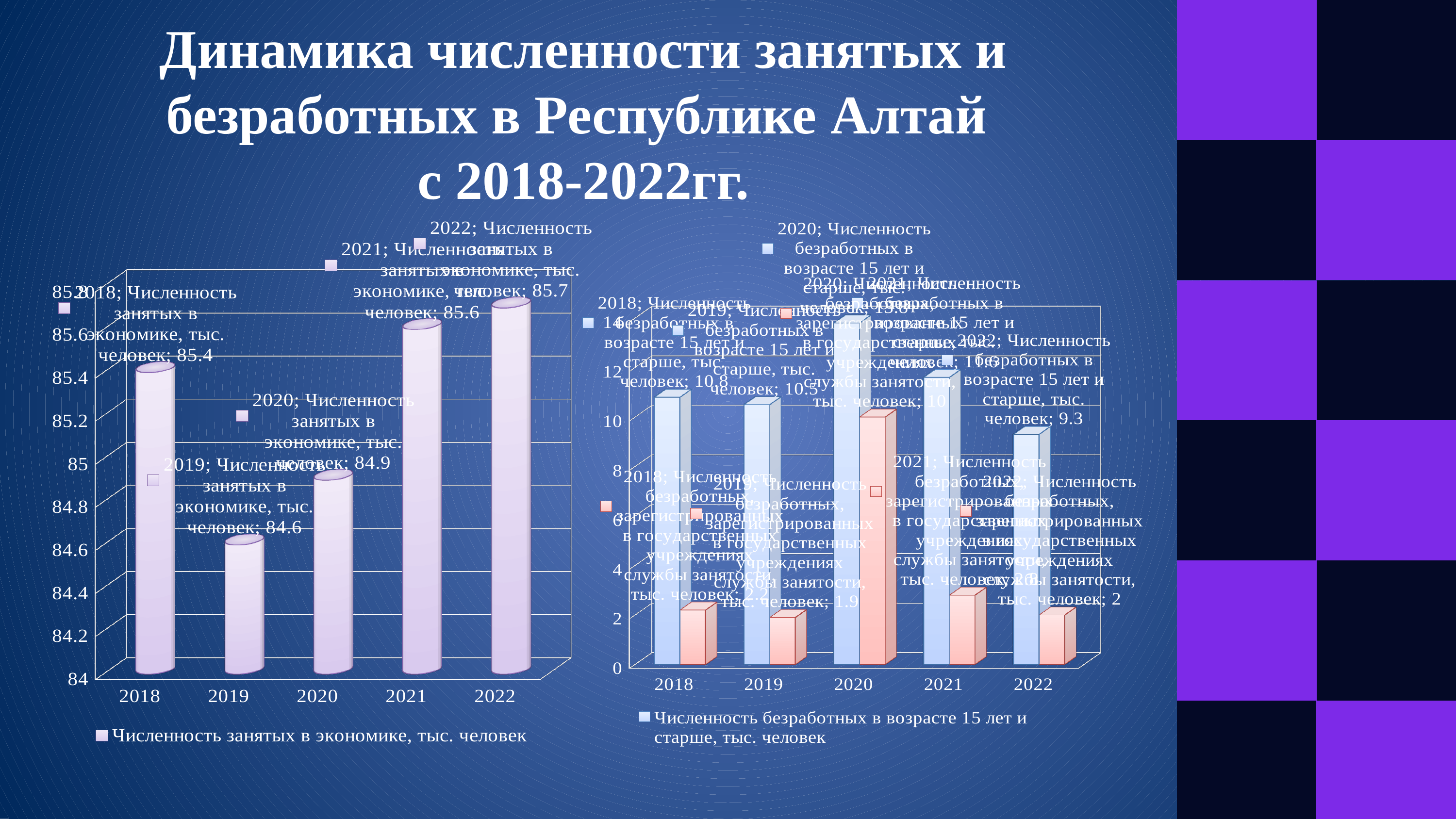
How many years are shown on the x axis of the left chart? 5 In the right chart, what is the value for 2020 for Численность безработных, зарегистрированных в государственных учреждениях службы занятости? 10 What kind of chart is the left chart (Численность занятых в экономике)? bar chart In the left chart, what is the value for 2018? 85.4 In the right chart, what is the value for 2022 for Численность безработных в возрасте 15 лет и старше? 9.3 In the right chart, what is the value for 2018 for Численность безработных в возрасте 15 лет и старше? 10.8 In the left chart, what is the difference between the values for 2022 and 2019? 1.1 What series does the legend of the left chart list? Численность занятых в экономике, тыс. человек In the left chart, what is the value for 2019? 84.6 In the left chart, which year has the highest value? 2022 In the left chart, which year has the lowest value? 2019 In the right chart, is the value for 2020 for Численность безработных в возрасте 15 лет и старше greater or less than 12? greater